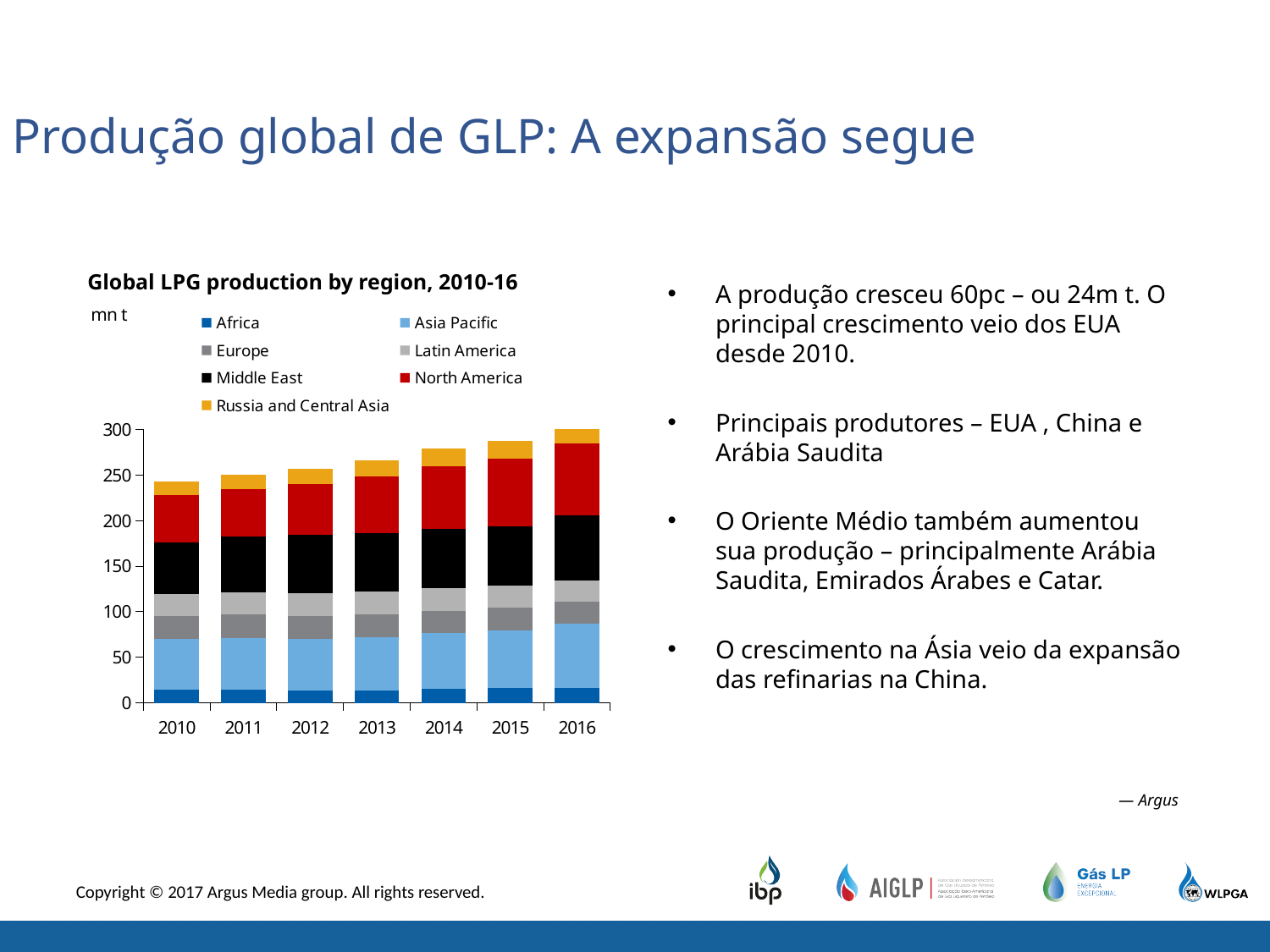
Is the total LPG production for 2014 greater or less than 250? greater Which year has the highest total global LPG production in the chart? 2016 What unit is shown on the chart's y axis? mn t How many series does the chart legend list? 7 Is the total LPG production for 2010 greater or less than 250? less Which year has a larger total LPG production, 2010 or 2016? 2016 How many years are shown along the x axis of the chart? 7 What kind of chart is shown on the slide? Stacked bar chart What is the title of the chart? Global LPG production by region, 2010-16 Which year has the lowest total global LPG production in the chart? 2010 Does total global LPG production rise or fall from 2010 to 2016? Rise Is the total LPG production for 2015 greater or less than 250? greater